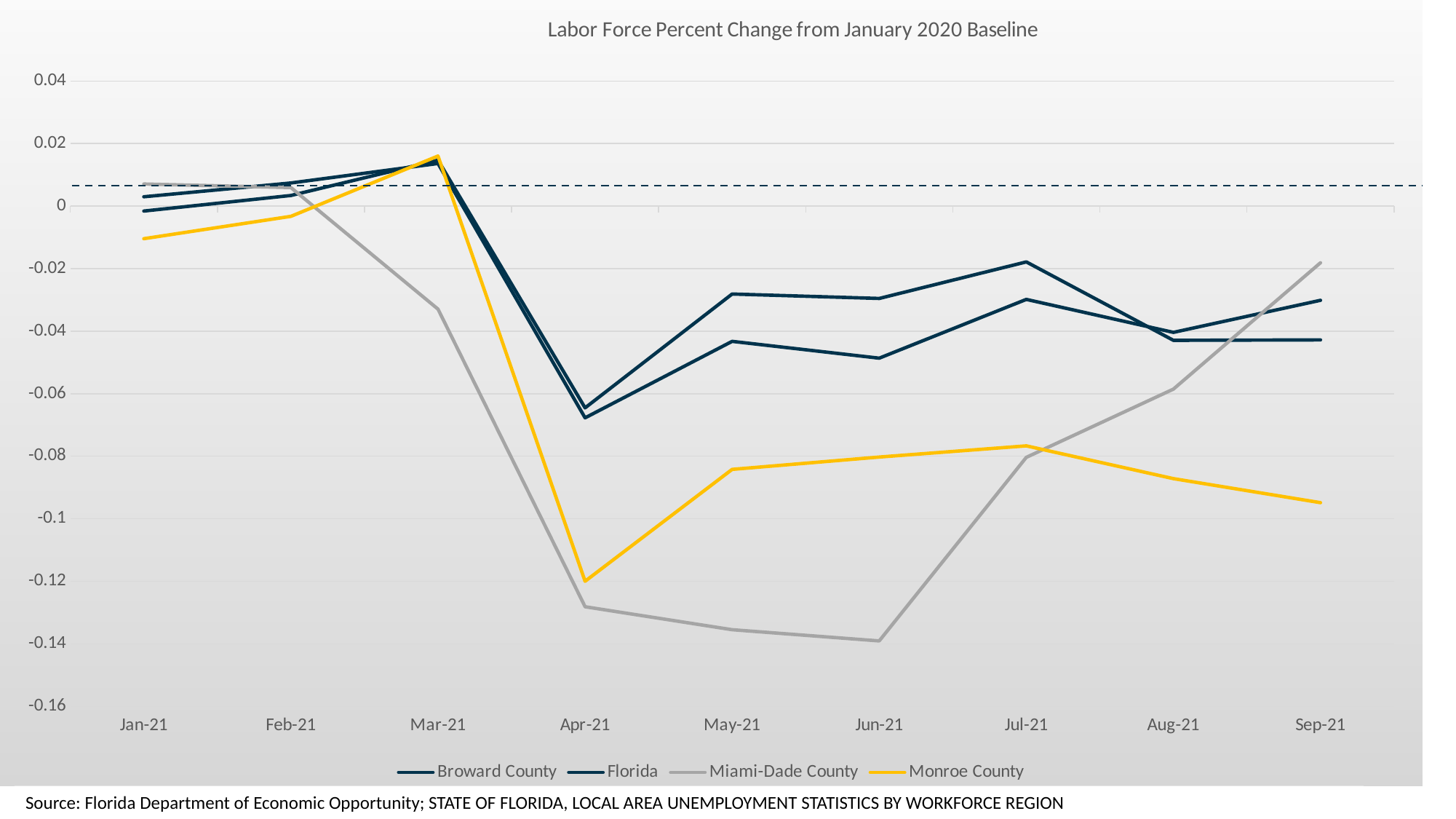
Is the value for Miami-Dade County in Jun-21 greater or less than -0.12? less Which colour is used for the Monroe County line? yellow Is the value for Miami-Dade County in Sep-21 greater or less than -0.04? greater Which series has the lowest value in Jun-21? Miami-Dade County What is the title of the chart? Labor Force Percent Change from January 2020 Baseline In Jun-21, which is larger: the value for Miami-Dade County or the value for Monroe County? Monroe County How many series does the legend list? 4 What kind of chart is shown on the slide? line chart Does the Miami-Dade County line rise or fall from Jun-21 to Sep-21? rise How many months are shown along the x axis? 9 Is the value for Monroe County in Apr-21 greater or less than -0.1? less